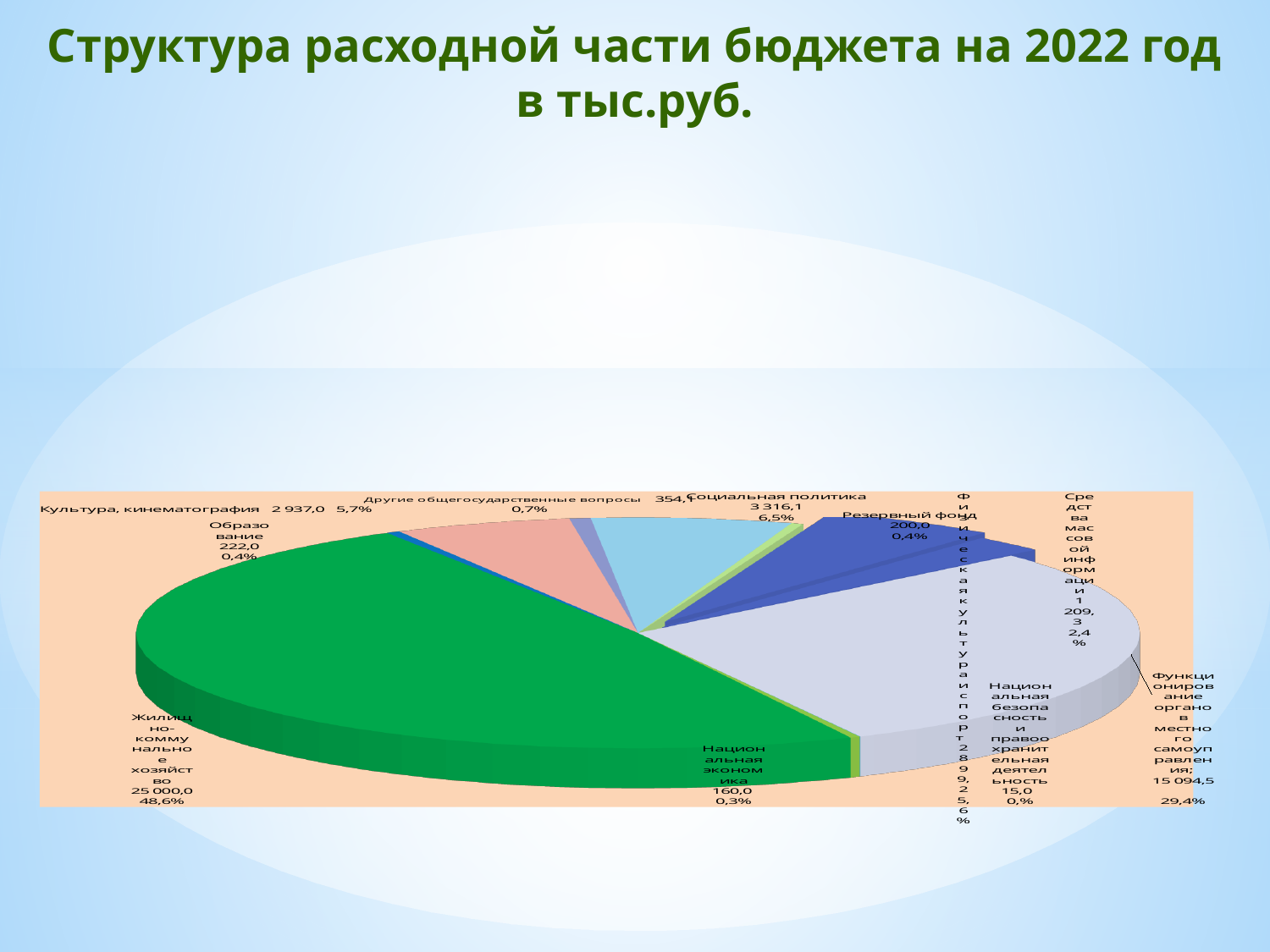
What is the value for Функционирование органов местного самоуправления? 15 094,5 Which is larger: Социальная политика or Культура, кинематография? Социальная политика What is the difference between the values for Образование and Резервный фонд? 22,0 What is the value for Социальная политика? 3 316,1 Which category has the largest slice of the pie? Жилищно-коммунальное хозяйство What share of the pie does Жилищно-коммунальное хозяйство take? 48,6% Which category has the smallest value? Национальная безопасность и правоохранительная деятельность What share of the pie does Функционирование органов местного самоуправления take? 29,4% What is the value for Жилищно-коммунальное хозяйство? 25 000,0 What kind of chart is shown on the slide? Pie chart What is the value for Культура, кинематография? 2 937,0 How many categories are shown in the pie chart? 11